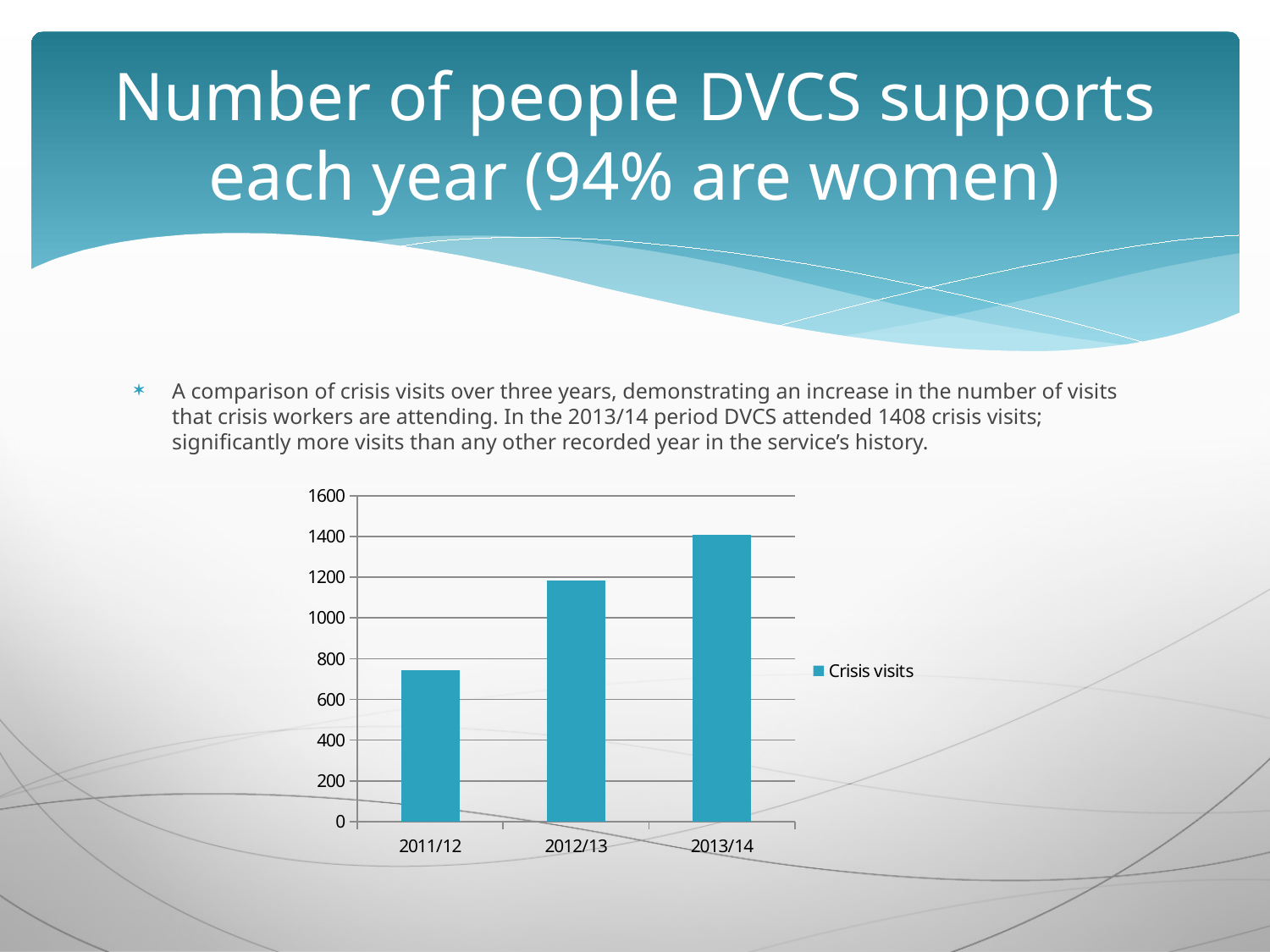
Is the value for 2011/12 greater or less than 800? less Which year has more crisis visits, 2011/12 or 2012/13? 2012/13 How many categories (years) are shown on the x axis of the chart? 3 Is the value for 2012/13 greater or less than 1000? greater Is the value for 2011/12 greater or less than 600? greater Which year has the lowest number of crisis visits in the chart? 2011/12 Do the crisis visit values rise or fall from 2011/12 to 2013/14? rise According to the slide, how many crisis visits did DVCS attend in the 2013/14 period? 1408 How many series does the chart's legend list? 1 What type of chart is shown on the slide? bar chart Which year has the highest number of crisis visits in the chart? 2013/14 What is the name of the series shown in the chart's legend? Crisis visits